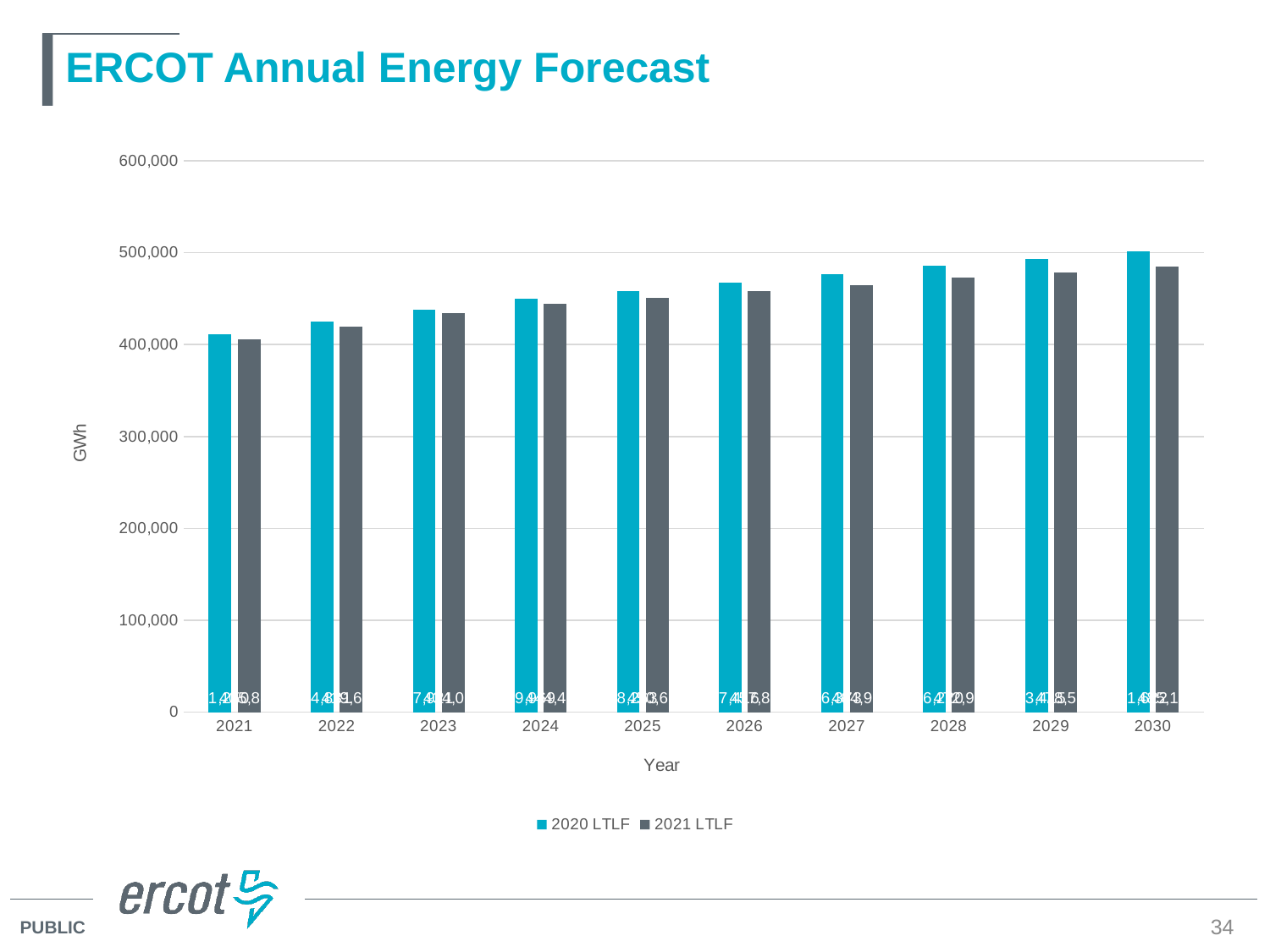
How many series does the legend list? 2 In 2030, which series has the larger value, 2020 LTLF or 2021 LTLF? 2020 LTLF Which year has the highest 2020 LTLF value? 2030 What unit is shown on the y axis label? GWh What type of chart is shown on the slide? bar chart What is the title of the chart? ERCOT Annual Energy Forecast How many years are shown on the x axis? 10 Is the 2021 LTLF value for 2030 greater or less than 500,000? less Which year has the lowest 2021 LTLF value? 2021 Is the 2020 LTLF value for 2021 greater or less than 400,000? greater Is the 2021 LTLF value for 2024 greater or less than 400,000? greater Do the 2020 LTLF values rise or fall from 2021 to 2030? rise